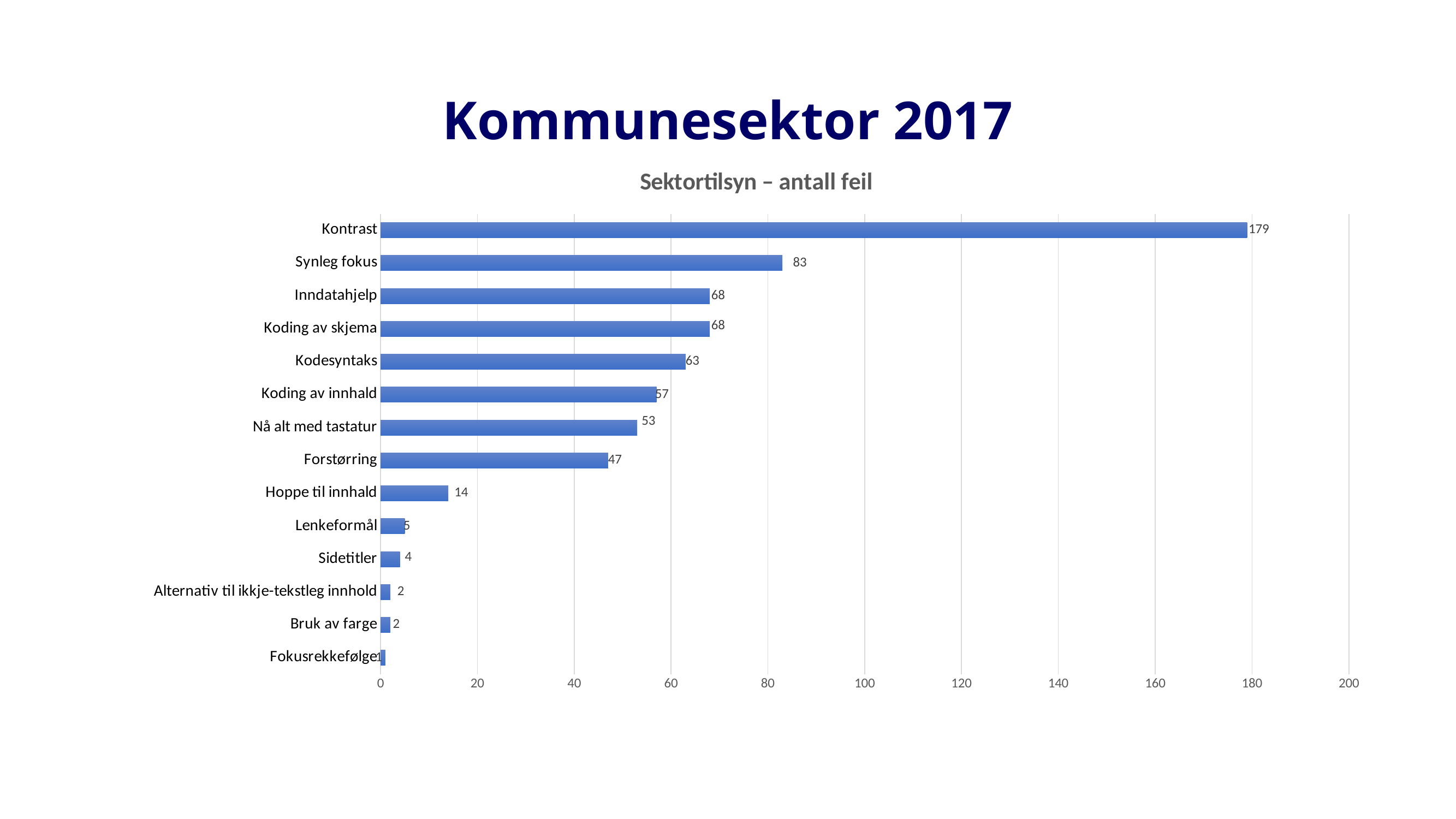
What is the value for Kontrast? 179 Which category has the highest value? Kontrast Which category has the lowest value? Fokusrekkefølge What is the value for Hoppe til innhald? 14 What is the title of the chart? Sektortilsyn – antall feil How many categories are shown in the chart? 14 What is the value for Synleg fokus? 83 Which is larger, the value for Kodesyntaks or the value for Koding av innhald? Kodesyntaks Is the value for Nå alt med tastatur greater or less than 60? less What is the value for Forstørring? 47 What is the difference between the values for Kontrast and Synleg fokus? 96 What kind of chart is shown on the slide? bar chart